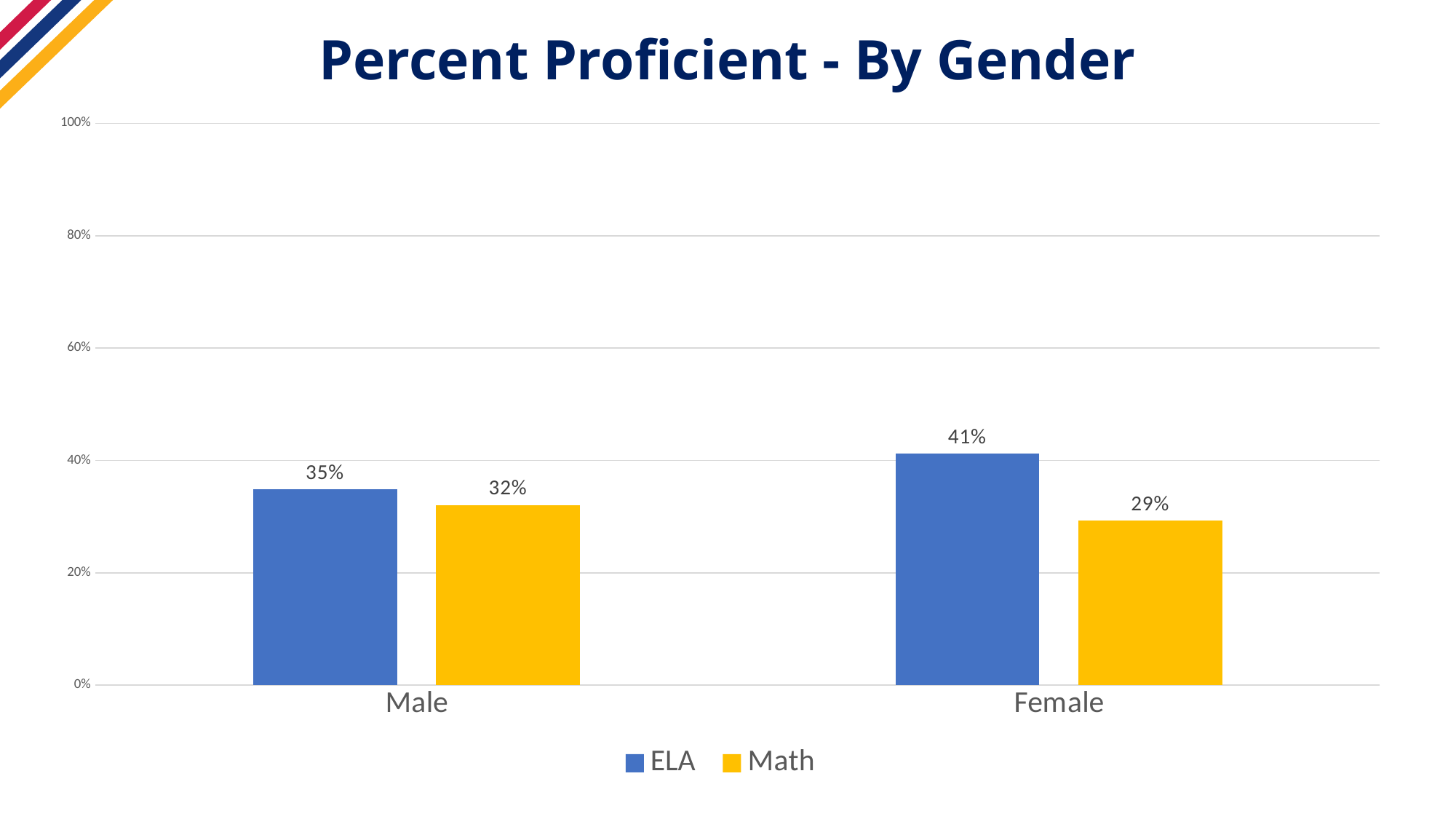
Which is larger for Female: ELA or Math? ELA How many series does the legend list? 2 What is the Math percent proficient for Female? 29% What kind of chart is shown on the slide? Bar chart What is the ELA percent proficient for Male? 35% Is the Female ELA value greater or less than 40%? greater How many gender categories are shown on the x axis? 2 What is the difference between the Male Math value and the Female Math value? 3% Which gender has the lowest Math percent proficient? Female What is the Math percent proficient for Male? 32% What is the difference between the Female ELA value and the Male ELA value? 6% Which gender has the highest ELA percent proficient? Female